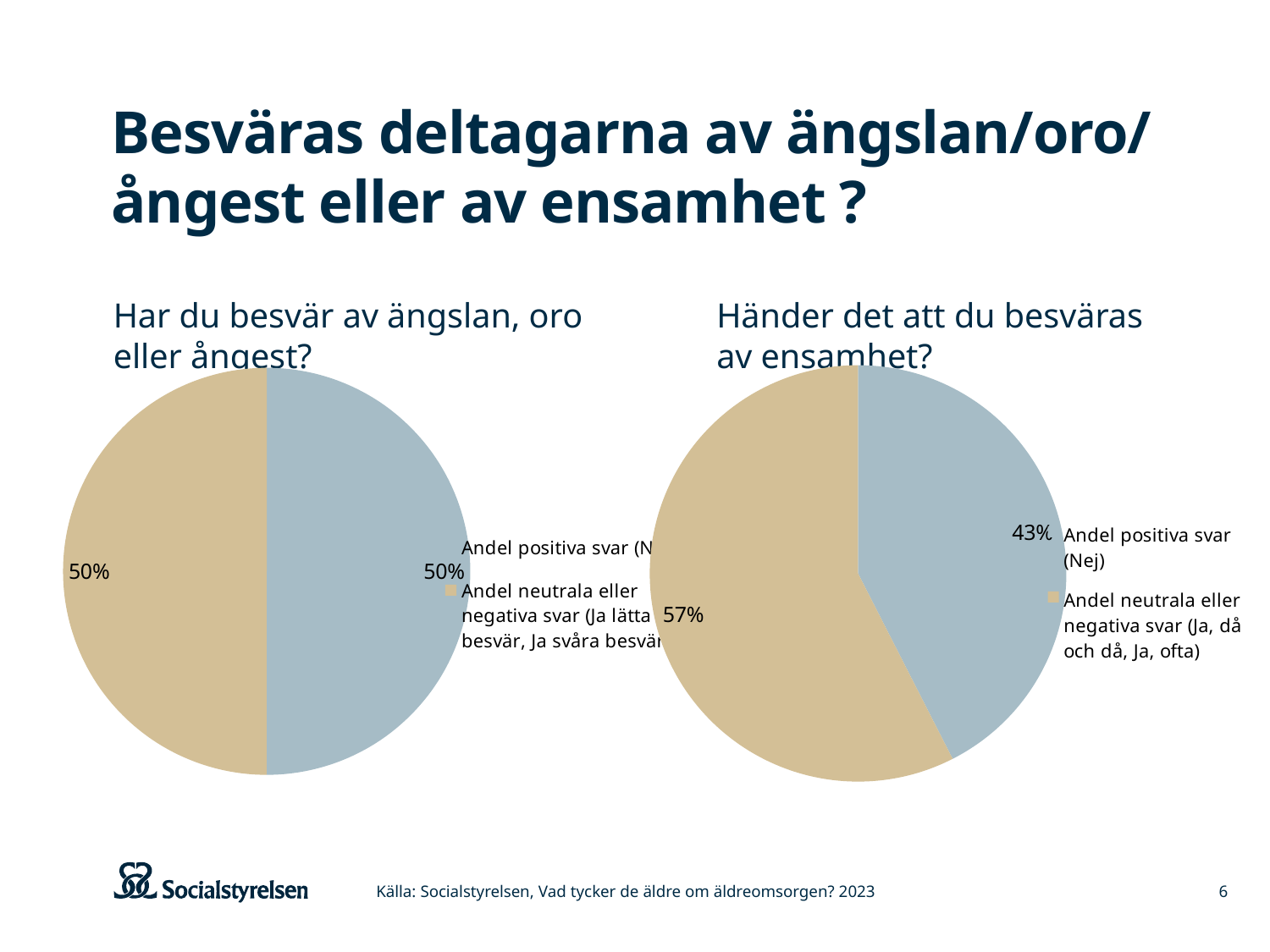
How many entries does the legend of the chart titled "Händer det att du besväras av ensamhet?" list? 2 In the chart titled "Har du besvär av ängslan, oro eller ångest?", what share of answers is "Andel neutrala eller negativa svar"? 50% In the chart titled "Händer det att du besväras av ensamhet?", which slice is the smallest? Andel positiva svar (Nej) How many slices does the chart titled "Händer det att du besväras av ensamhet?" have? 2 How many pie charts are shown on the slide? 2 In the chart titled "Händer det att du besväras av ensamhet?", which slice is the largest? Andel neutrala eller negativa svar (Ja, då och då, Ja, ofta) What kind of chart is used for "Har du besvär av ängslan, oro eller ångest?"? pie chart In the chart titled "Händer det att du besväras av ensamhet?", what share of answers is "Andel neutrala eller negativa svar (Ja, då och då, Ja, ofta)"? 57% In the chart titled "Händer det att du besväras av ensamhet?", what is the difference in percentage points between the neutral/negative share and the positive share? 14 percentage points In the chart titled "Händer det att du besväras av ensamhet?", what colour is the slice for "Andel positiva svar (Nej)"? blue-grey In the chart titled "Händer det att du besväras av ensamhet?", what share of answers is "Andel positiva svar (Nej)"? 43% In the chart titled "Händer det att du besväras av ensamhet?", is the share of "Andel positiva svar (Nej)" larger or smaller than the share of neutral or negative answers? smaller